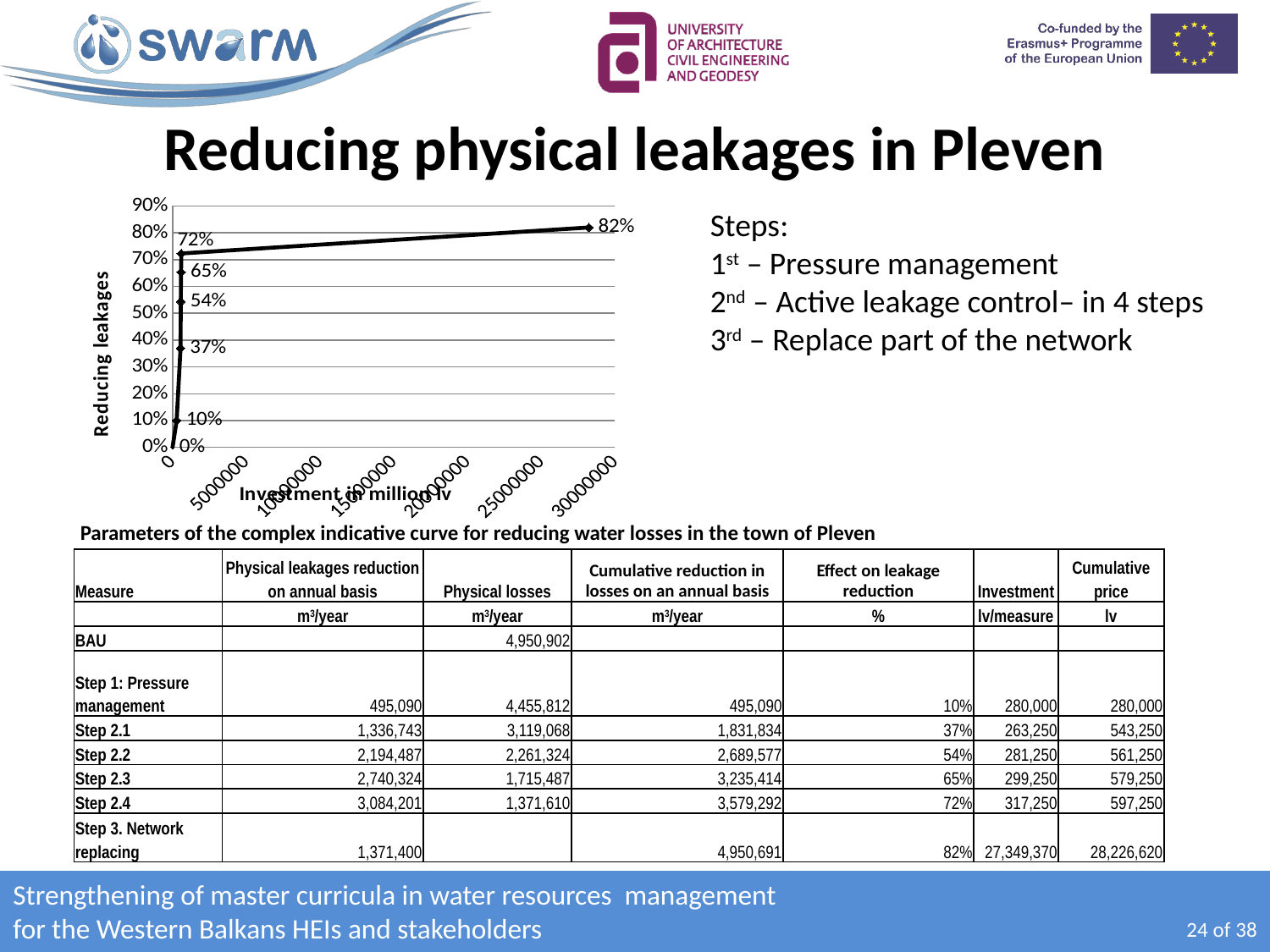
What is the difference between the highest labelled value (82%) and the next highest (72%)? 10 percentage points How many data points are plotted on the chart? 7 Which is larger, the value labelled 54% or the value labelled 65%? 65% Is the investment for the rightmost point greater or less than 25000000? greater What is the highest value labelled on the chart? 82% What is the lowest value labelled on the chart? 0% Do the values rise or fall as investment increases along the x axis? rise What is the title of the vertical axis? Reducing leakages What is the data label of the rightmost point on the chart? 82% What is the title of the horizontal axis? Investment in million lv What is the data label of the second point from the left on the chart? 10% What kind of chart is shown on the slide? line chart